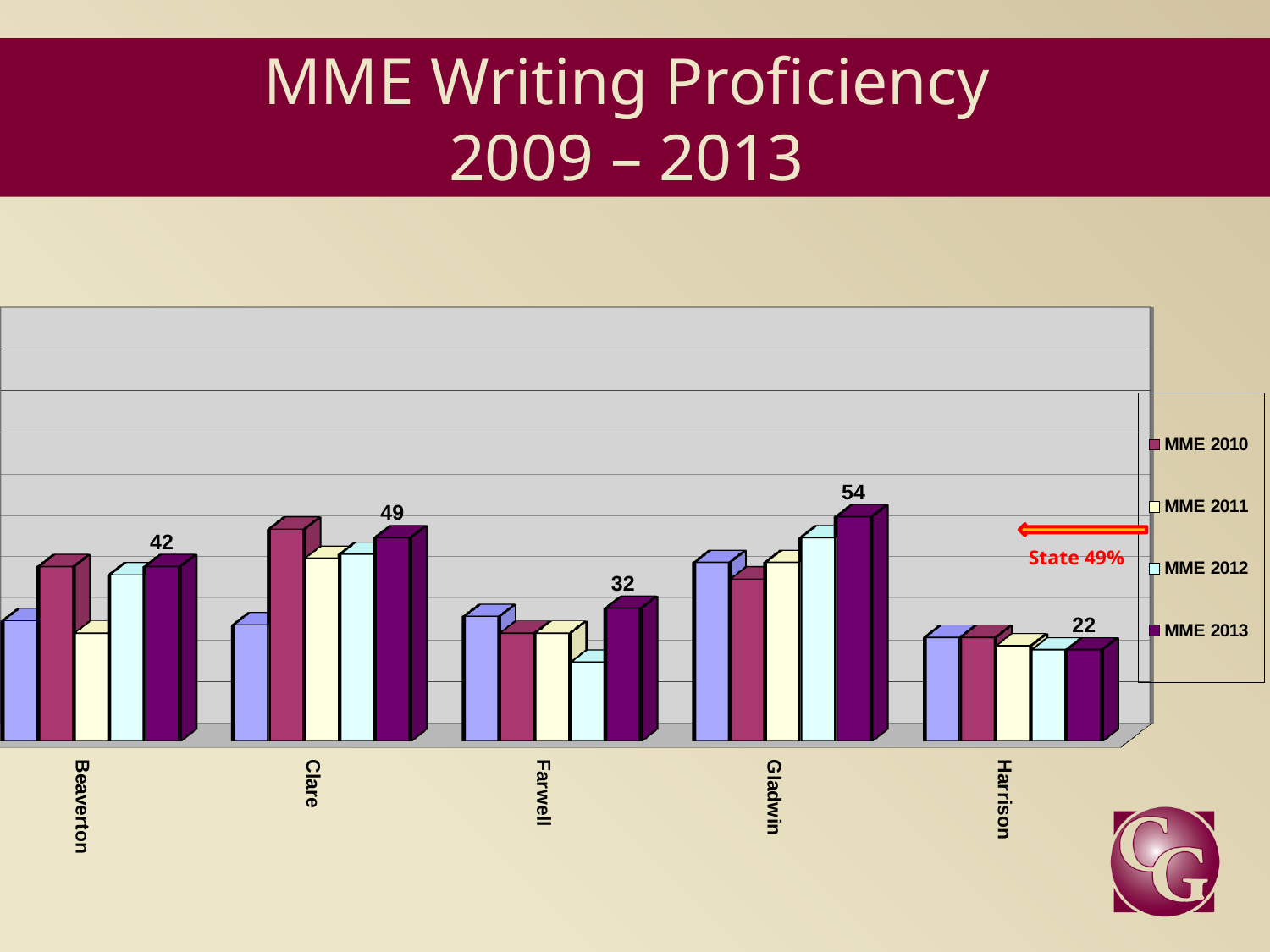
What kind of chart is shown on the slide? Bar chart What state percentage is indicated by the red arrow annotation? 49% What is the difference between the MME 2013 values for Gladwin and Harrison? 32 What is the MME 2013 value for Farwell? 32 What is the MME 2013 value for Gladwin? 54 What is the MME 2013 value for Harrison? 22 How many districts are shown on the x axis? 5 Which district has the highest MME 2013 value? Gladwin What is the MME 2013 value for Clare? 49 Which district has the lowest MME 2013 value? Harrison What is the MME 2013 value for Beaverton? 42 Which has the larger MME 2013 value, Beaverton or Farwell? Beaverton